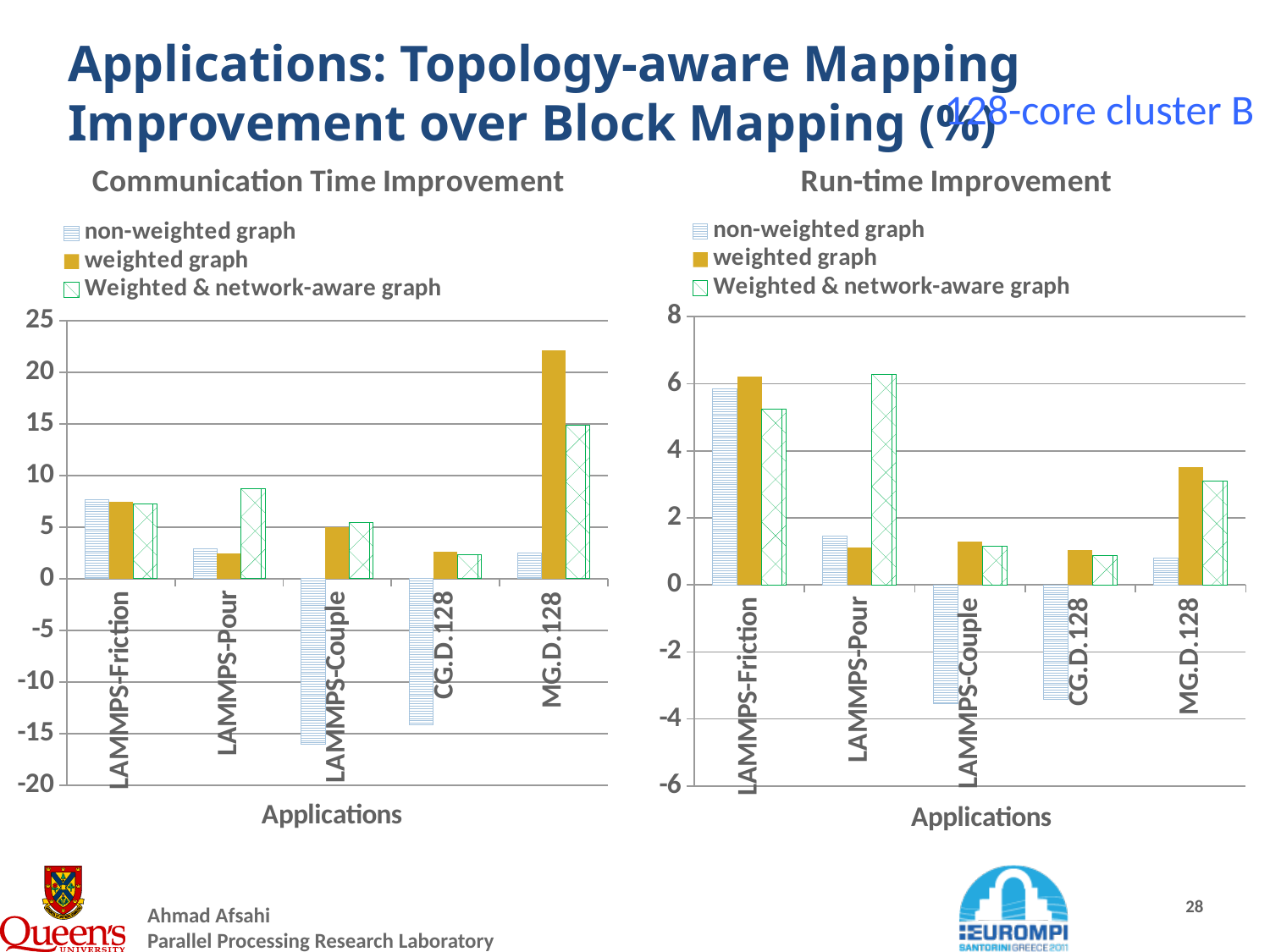
What kind of chart is the Communication Time Improvement chart? bar chart In the Run-time Improvement chart, for LAMMPS-Friction, which is larger: the weighted graph value or the Weighted & network-aware graph value? weighted graph In the Communication Time Improvement chart, which application has the highest weighted graph value? MG.D.128 In the Communication Time Improvement chart, for LAMMPS-Pour, which is larger: the weighted graph value or the Weighted & network-aware graph value? Weighted & network-aware graph In the Run-time Improvement chart, which application has the highest Weighted & network-aware graph value? LAMMPS-Pour How many series does the legend of the Communication Time Improvement chart list? 3 What is the x-axis title of the Run-time Improvement chart? Applications In the Communication Time Improvement chart, is the non-weighted graph value for LAMMPS-Couple greater or less than -15? less How many applications are shown on the x axis of the Run-time Improvement chart? 5 In the Run-time Improvement chart, is the non-weighted graph value for LAMMPS-Couple greater or less than -2? less In the Run-time Improvement chart, is the Weighted & network-aware graph value for LAMMPS-Pour greater or less than 6? greater